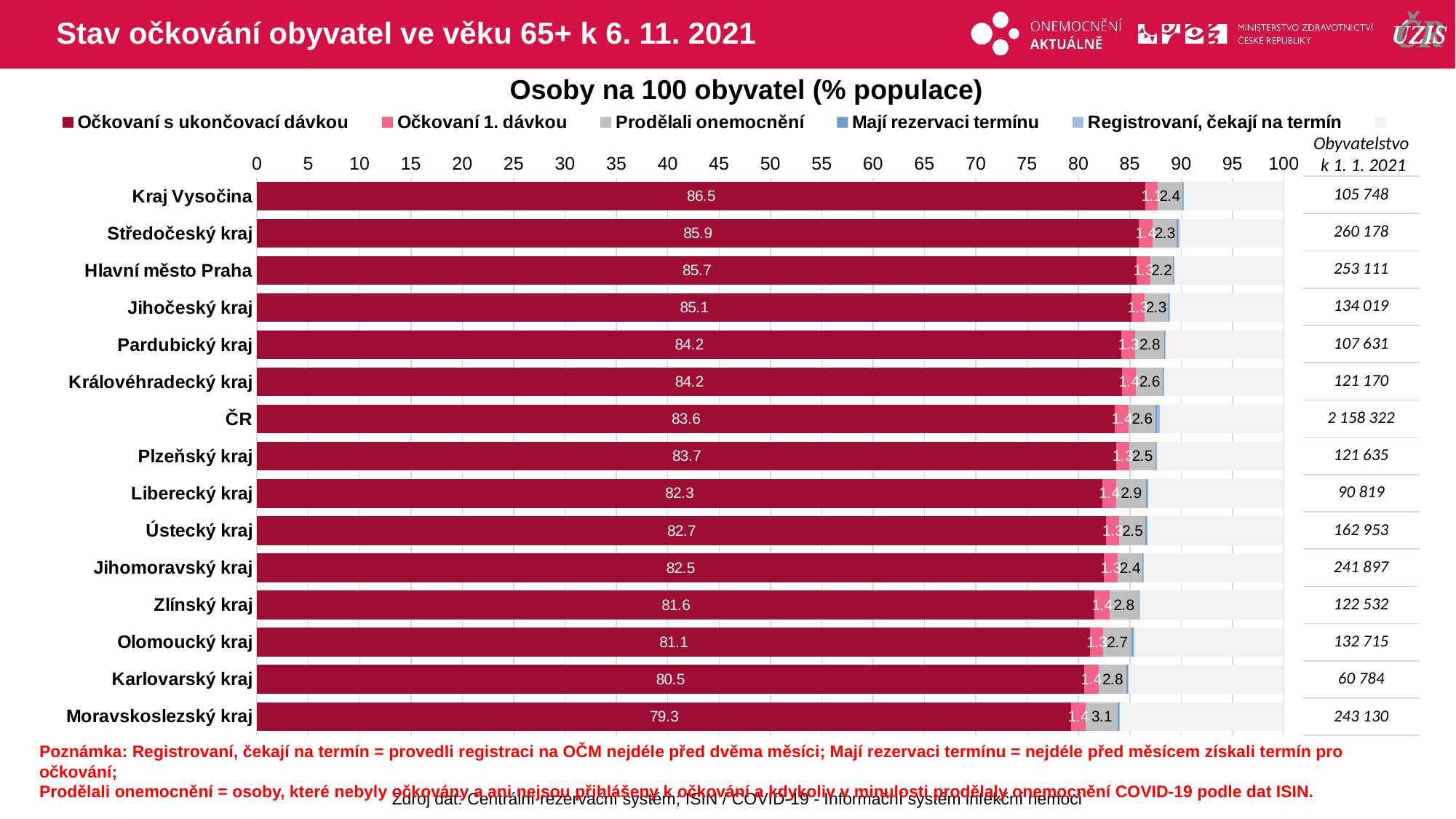
How many labelled series does the legend list? 5 Which region has the lowest value of 'Očkovaní s ukončovací dávkou'? Moravskoslezský kraj What is the value of 'Očkovaní s ukončovací dávkou' for ČR? 83.6 What is the value of 'Prodělali onemocnění' for Moravskoslezský kraj? 3.1 How many regions (categories) are plotted in the chart? 15 Is the value of 'Očkovaní s ukončovací dávkou' for Moravskoslezský kraj greater or less than 80? less What is the value of 'Očkovaní s ukončovací dávkou' for Kraj Vysočina? 86.5 What type of chart is shown on the slide? Stacked horizontal bar chart What is the difference in 'Očkovaní s ukončovací dávkou' between Kraj Vysočina and Moravskoslezský kraj? 7.2 Which region has the highest value of 'Očkovaní s ukončovací dávkou'? Kraj Vysočina Which has a larger value of 'Očkovaní s ukončovací dávkou': Středočeský kraj or Olomoucký kraj? Středočeský kraj What is the title of the chart? Osoby na 100 obyvatel (% populace)